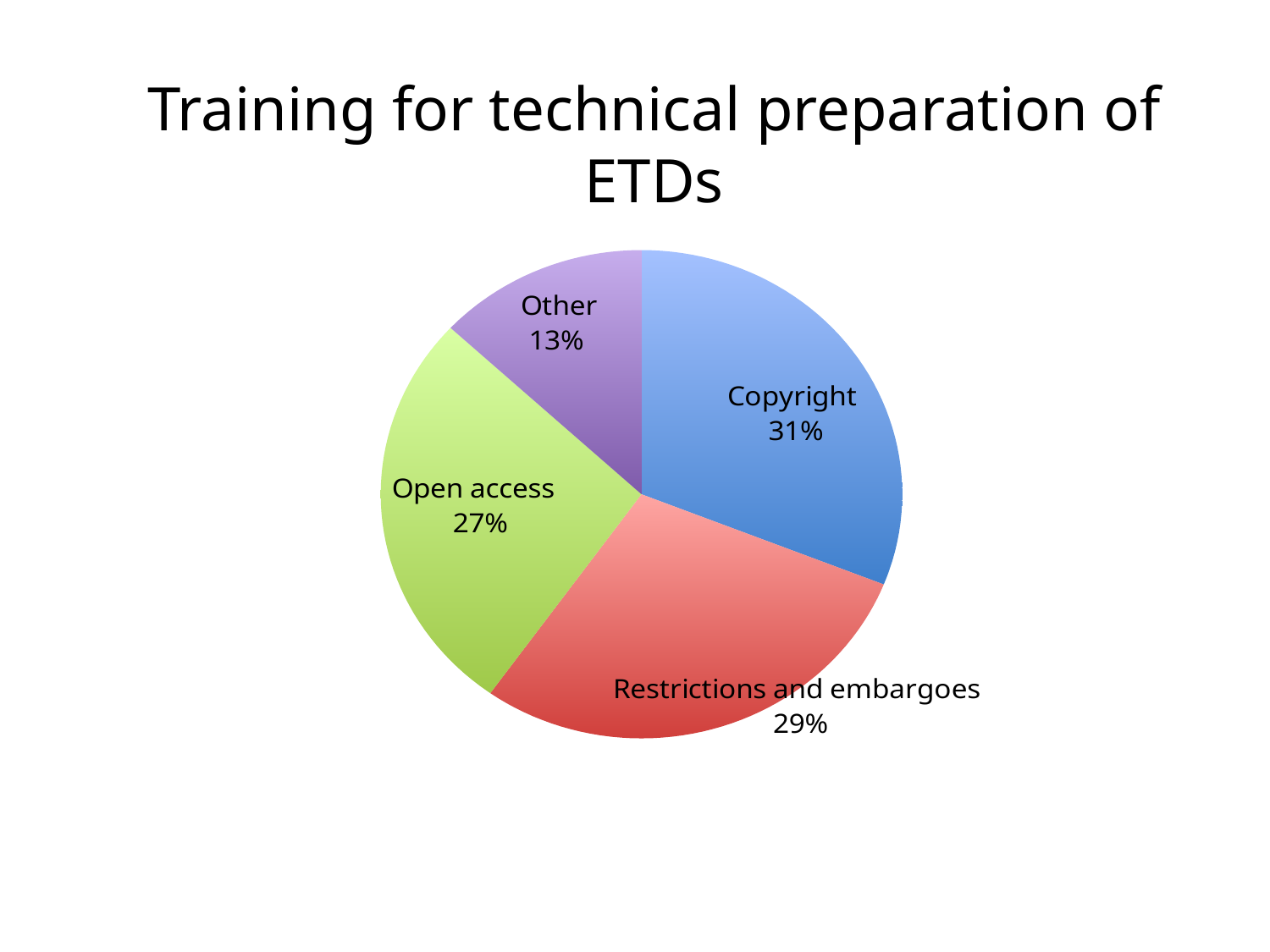
What is the difference in percentage points between Restrictions and embargoes and Open access? 2 What share of the pie does Open access represent? 27% How many slices does the pie chart have? 4 What share of the pie does Restrictions and embargoes represent? 29% What share of the pie does Copyright represent? 31% What is the title of the slide containing the pie chart? Training for technical preparation of ETDs Which is larger, the Copyright slice or the Open access slice? Copyright Which slice of the pie is the largest? Copyright What is the difference in percentage points between Copyright and Other? 18 Which slice of the pie is the smallest? Other What kind of chart is shown on the slide? pie chart